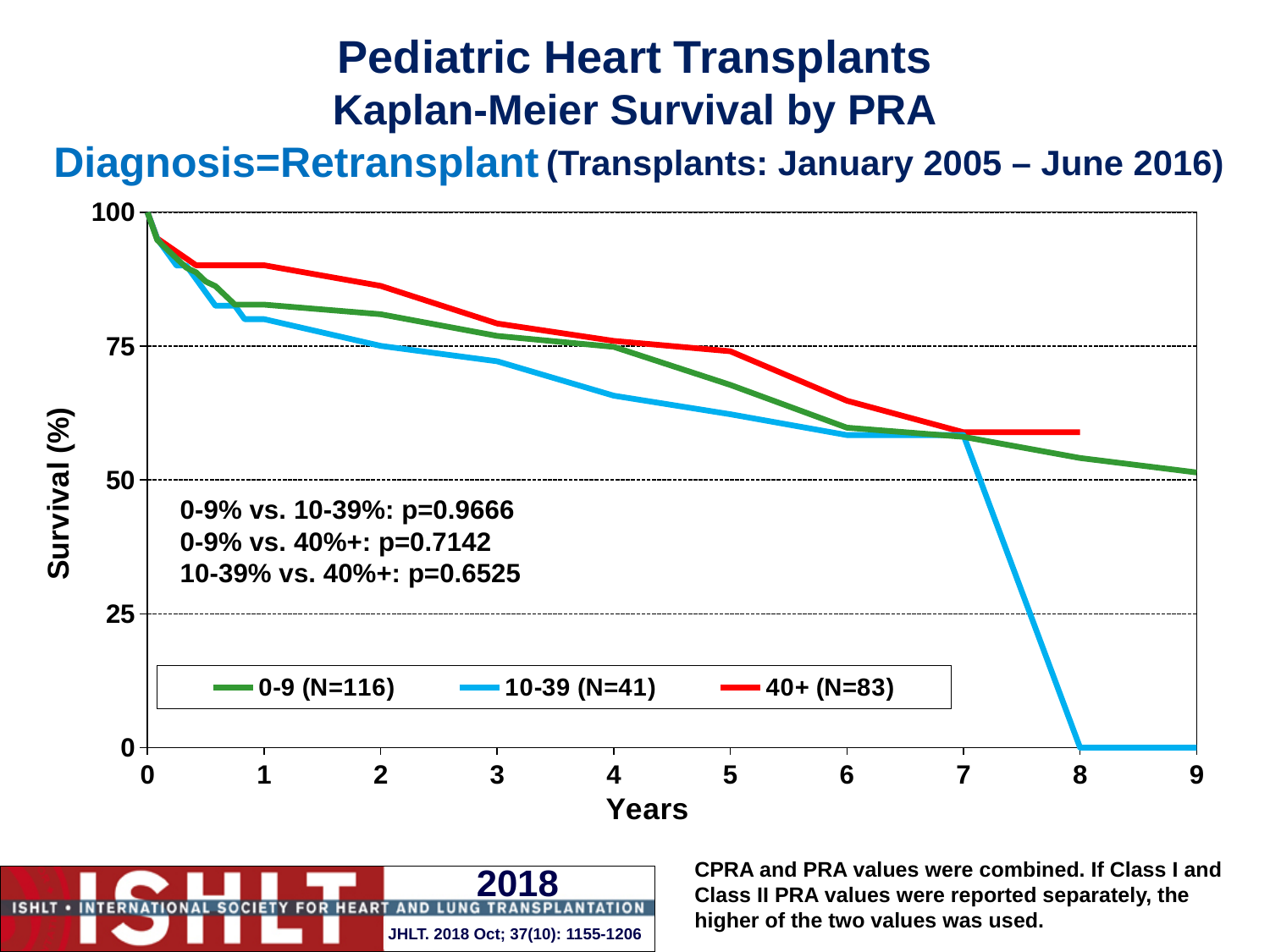
Do the survival values rise or fall as years increase? fall What kind of chart is shown on the slide? line chart Which series has the lowest survival at year 3? 10-39 (N=41) Is the survival value for the 40+ (N=83) series at year 1 greater or less than 75? greater Which series has the highest survival at year 2? 40+ (N=83) Is the survival value for the 10-39 (N=41) series at year 4 greater or less than 75? less Is the survival value for the 40+ (N=83) series at year 8 greater or less than 50? greater Which series has the lowest survival at year 8? 10-39 (N=41) What is the survival value for all three series at year 0? 100 How many series does the legend list? 3 What is the survival value for the 10-39 (N=41) series at year 8? 0 What is the label of the y axis? Survival (%)